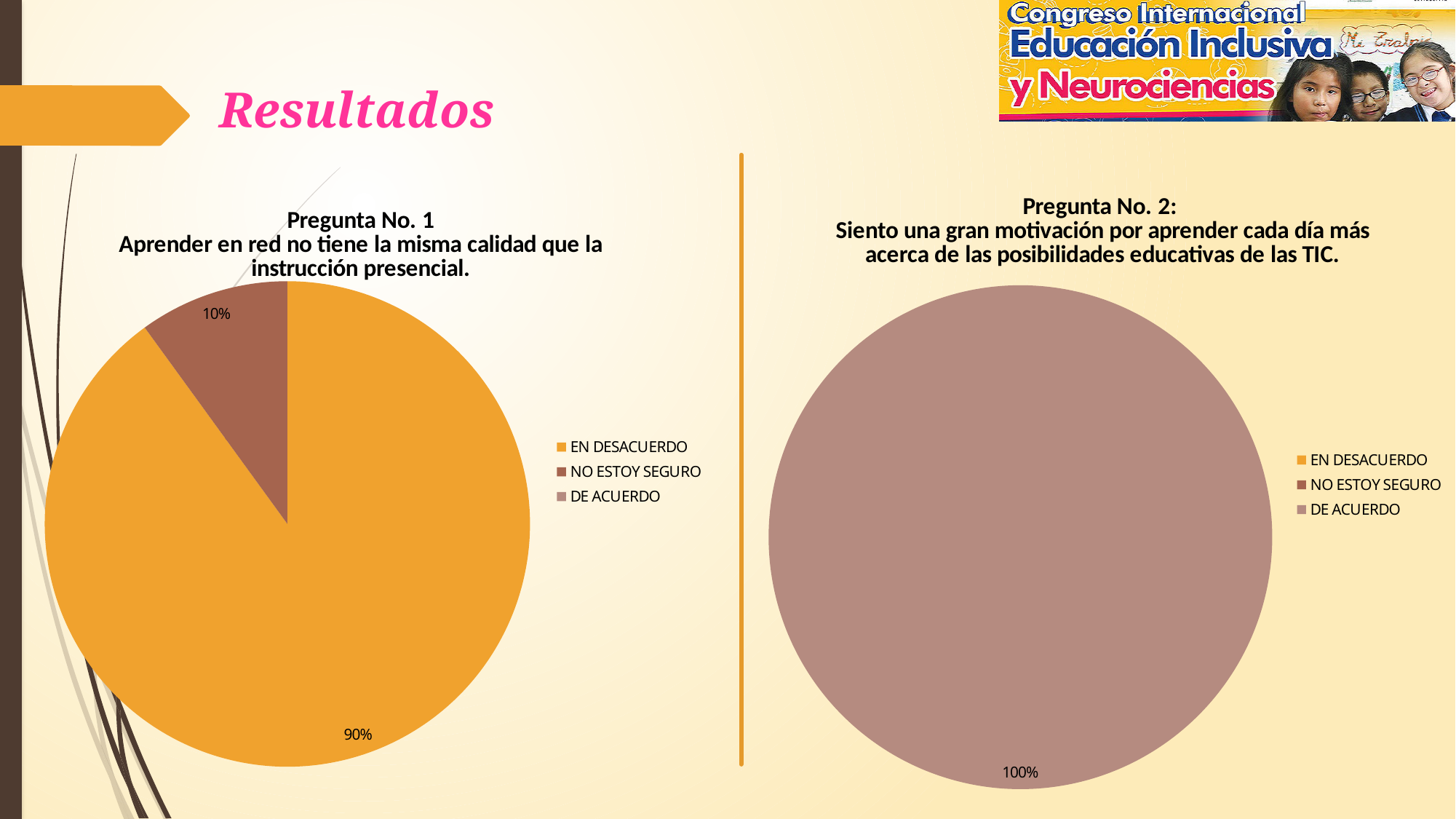
How many entries does the legend of the Pregunta No. 1 chart list? 3 In the Pregunta No. 2 chart, what share of the pie is DE ACUERDO? 100% What is the title of the chart on the right side of the slide? Pregunta No. 2: Siento una gran motivación por aprender cada día más acerca de las posibilidades educativas de las TIC. In the Pregunta No. 2 chart, which legend entry corresponds to the colour filling the whole pie? DE ACUERDO In the Pregunta No. 1 chart, how many slices are visible in the pie? 2 In the Pregunta No. 1 chart, which of the visible slices is the smallest? NO ESTOY SEGURO In the Pregunta No. 1 chart, what share of the pie is EN DESACUERDO? 90% What kind of chart is used for Pregunta No. 2? Pie chart In the Pregunta No. 1 chart, what share of the pie is NO ESTOY SEGURO? 10% In the Pregunta No. 1 chart, which is larger: EN DESACUERDO or NO ESTOY SEGURO? EN DESACUERDO In the Pregunta No. 1 chart, which category has the largest slice? EN DESACUERDO In the Pregunta No. 1 chart, what is the difference between the EN DESACUERDO and NO ESTOY SEGURO shares? 80%